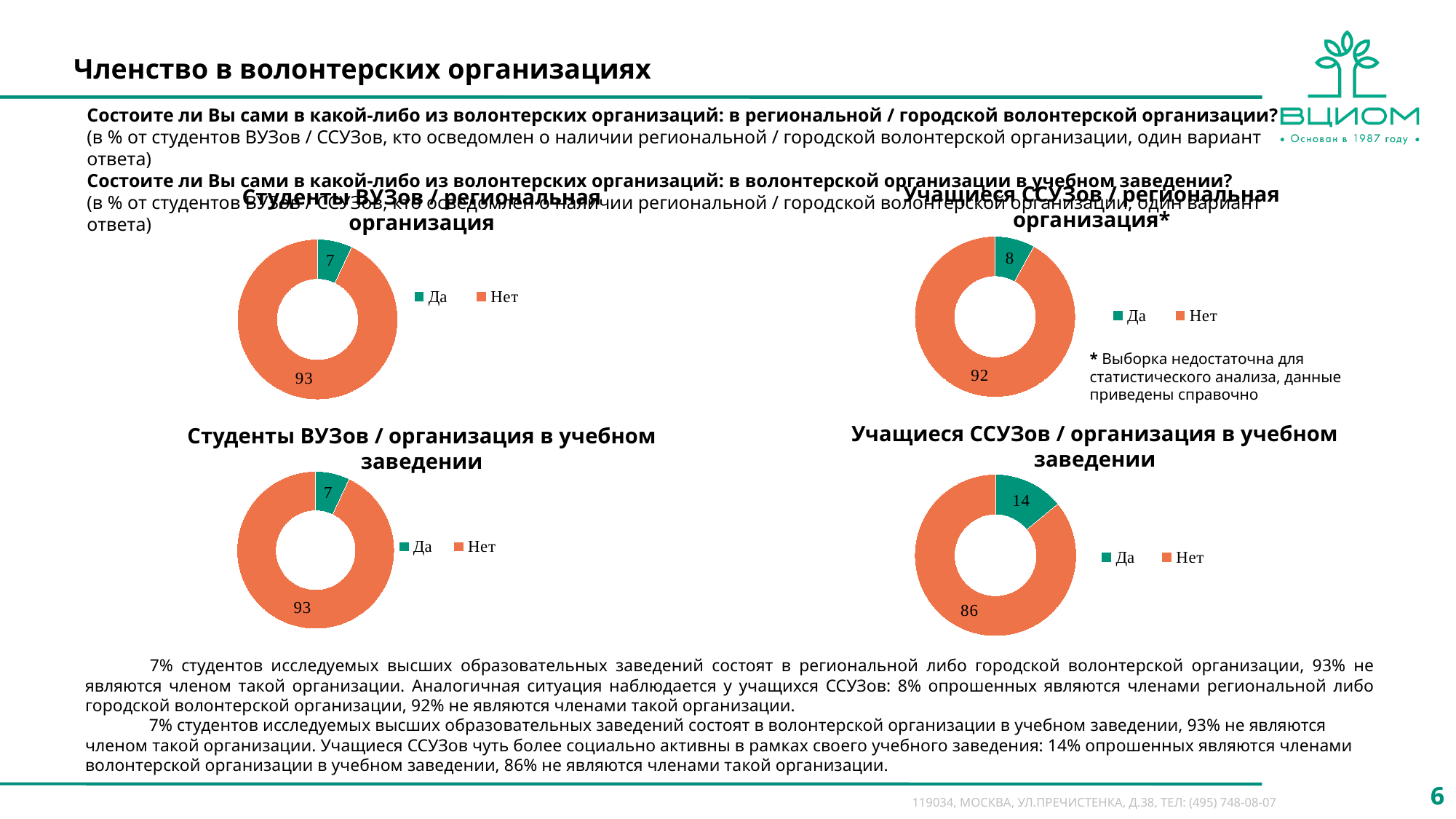
In the bottom-right chart 'Учащиеся ССУЗов / организация в учебном заведении', what is the value for 'Да'? 14 How many charts are shown on the slide? 4 In the top-left chart 'Студенты ВУЗов / региональная организация', what is the value for 'Да'? 7 In the top-right chart 'Учащиеся ССУЗов / региональная организация*', what is the value for 'Нет'? 92 What type of chart is the top-left chart 'Студенты ВУЗов / региональная организация'? Donut (pie) chart In the top-left chart 'Студенты ВУЗов / региональная организация', what is the value for 'Нет'? 93 In the bottom-left chart 'Студенты ВУЗов / организация в учебном заведении', which category has the largest share? Нет In the bottom-right chart 'Учащиеся ССУЗов / организация в учебном заведении', what is the value for 'Нет'? 86 In the top-right chart 'Учащиеся ССУЗов / региональная организация*', what is the value for 'Да'? 8 How many series does the legend of the top-right chart 'Учащиеся ССУЗов / региональная организация*' list? 2 Which is larger: the 'Да' value in the bottom-right chart 'Учащиеся ССУЗов / организация в учебном заведении' or the 'Да' value in the bottom-left chart 'Студенты ВУЗов / организация в учебном заведении'? Учащиеся ССУЗов / организация в учебном заведении In the bottom-right chart 'Учащиеся ССУЗов / организация в учебном заведении', what is the difference between the 'Нет' and 'Да' values? 72